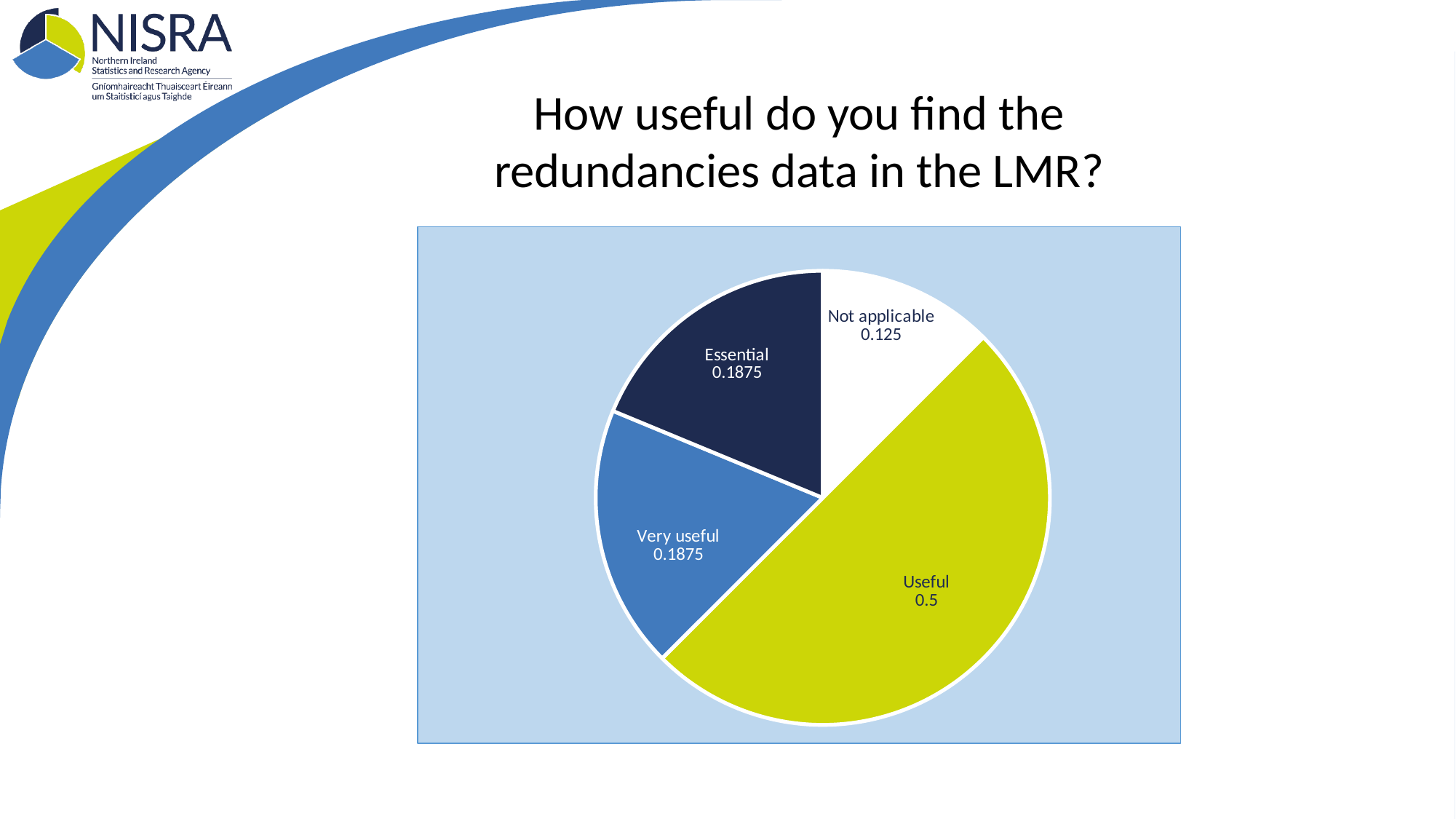
Which category has the largest slice of the pie? Useful What share of the pie does the Useful slice represent? 0.5 What is the value for the Very useful slice? 0.1875 How many slices does the pie chart have? 4 Which is larger, the value for Essential or the value for Not applicable? Essential What is the difference between the values for Useful and Not applicable? 0.375 What is the title of the slide above the chart? How useful do you find the redundancies data in the LMR? What is the value for the Not applicable slice? 0.125 What is the value for the Useful slice? 0.5 What kind of chart is shown on the slide? pie chart What is the value for the Essential slice? 0.1875 Which category has the smallest slice of the pie? Not applicable